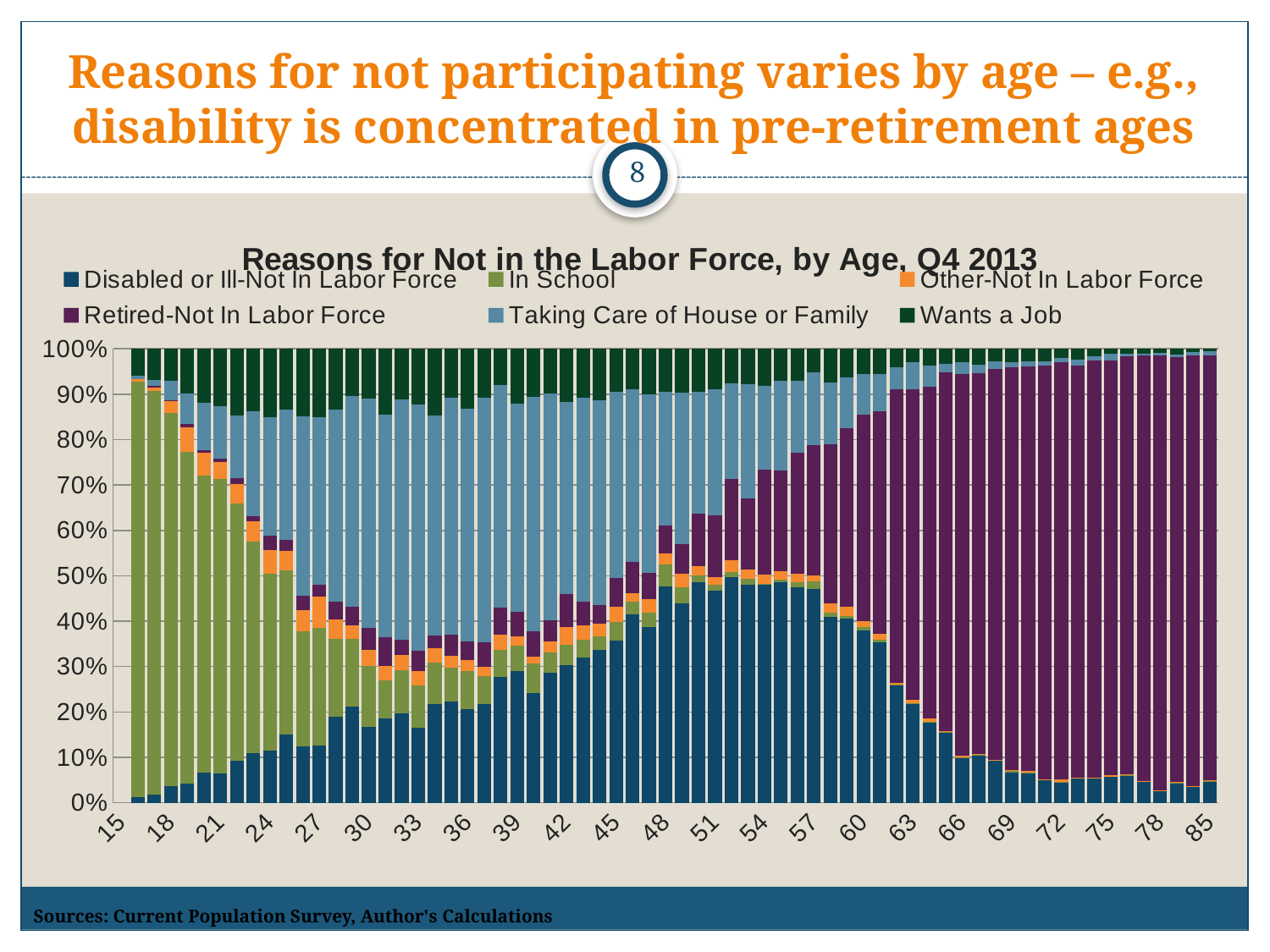
Does the 'In School' share rise or fall as age increases along the x axis? Falls What kind of chart is shown on the slide? Stacked bar chart Is the 'Disabled or Ill-Not In Labor Force' share at age 54 greater or less than 40%? greater How many series does the legend list? 6 At age 85, which is larger: the 'Retired-Not In Labor Force' share or the 'Disabled or Ill-Not In Labor Force' share? Retired-Not In Labor Force What is the title of the chart? Reasons for Not in the Labor Force, by Age, Q4 2013 Which colour represents the 'Retired-Not In Labor Force' series? Purple Does the 'Retired-Not In Labor Force' share rise or fall as age increases along the x axis? Rises Is the 'Disabled or Ill-Not In Labor Force' share at age 30 greater or less than 30%? less Is the 'Retired-Not In Labor Force' share at age 85 greater or less than 90%? greater